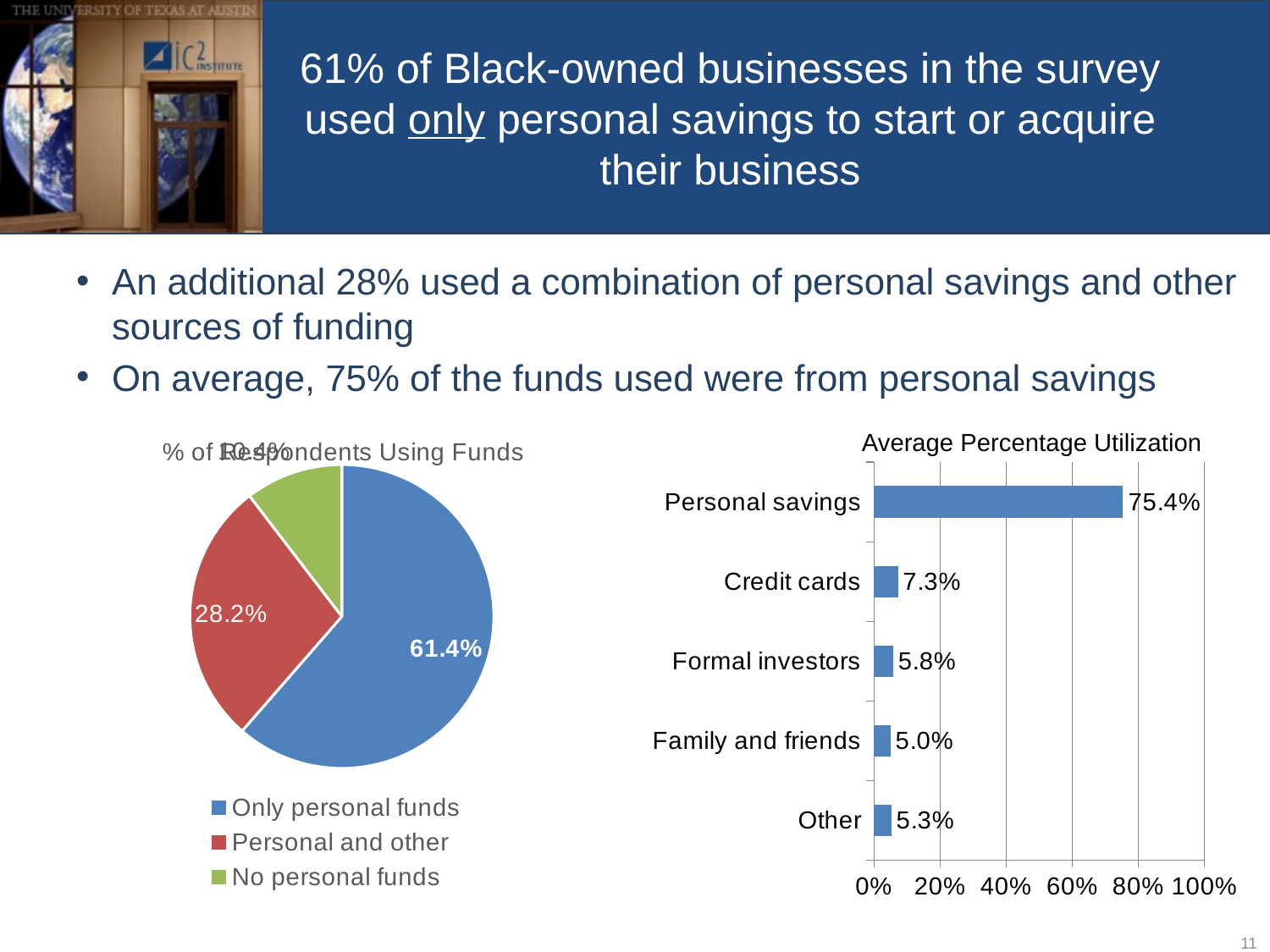
In the "Average Percentage Utilization" chart, what is the value for Family and friends? 5.0% In the "% of Respondents Using Funds" pie chart, what share is labelled for Only personal funds? 61.4% What kind of chart is the "Average Percentage Utilization" chart? Bar chart In the "% of Respondents Using Funds" pie chart, what share is labelled for Personal and other? 28.2% In the "Average Percentage Utilization" chart, how many categories are shown? 5 In the "Average Percentage Utilization" chart, which is larger: Formal investors or Other? Formal investors How many entries does the legend of the "% of Respondents Using Funds" pie chart list? 3 In the "Average Percentage Utilization" chart, which category has the highest value? Personal savings In the "Average Percentage Utilization" chart, what is the value for Personal savings? 75.4% In the "Average Percentage Utilization" chart, which category has the lowest value? Family and friends In the "Average Percentage Utilization" chart, what is the difference between Personal savings and Credit cards? 68.1% In the "Average Percentage Utilization" chart, what is the value for Credit cards? 7.3%